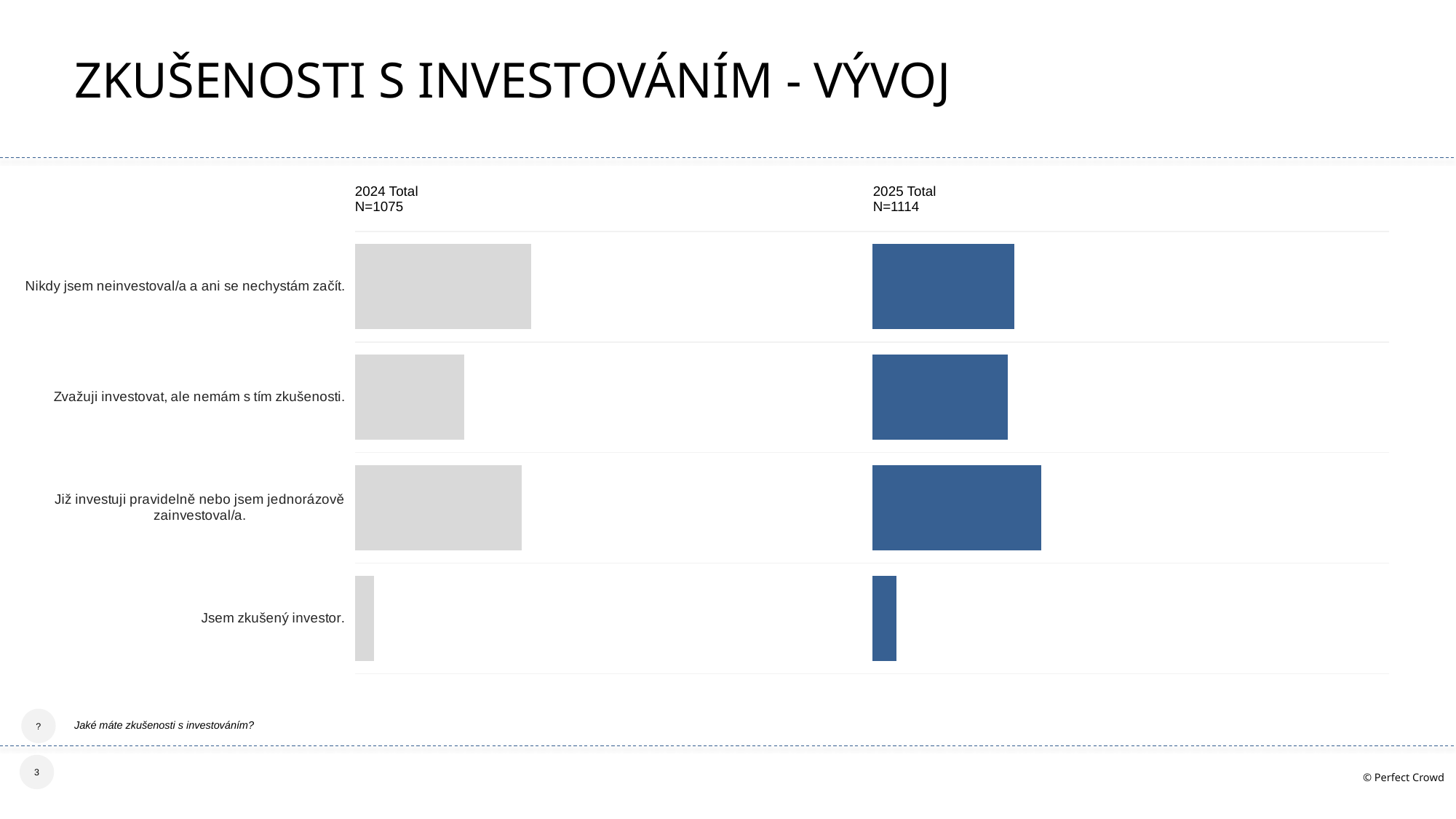
How many categories are shown in the 2024 Total chart? 4 In the 2025 Total chart, which category has the longest bar? Již investuji pravidelně nebo jsem jednorázově zainvestoval/a. What is the sample size (N) shown for the 2024 Total chart? N=1075 Is the bar for 'Zvažuji investovat, ale nemám s tím zkušenosti.' longer in the 2024 Total chart or the 2025 Total chart? 2025 Total In the 2025 Total chart, which category has the shortest bar? Jsem zkušený investor. Is the bar for 'Nikdy jsem neinvestoval/a a ani se nechystám začít.' longer in the 2024 Total chart or the 2025 Total chart? 2024 Total In the 2025 Total chart, which is larger: 'Zvažuji investovat, ale nemám s tím zkušenosti.' or 'Již investuji pravidelně nebo jsem jednorázově zainvestoval/a.'? Již investuji pravidelně nebo jsem jednorázově zainvestoval/a. In the 2024 Total chart, which category has the shortest bar? Jsem zkušený investor. What is the sample size (N) shown for the 2025 Total chart? N=1114 What kind of chart is used for the 2024 Total data? bar chart